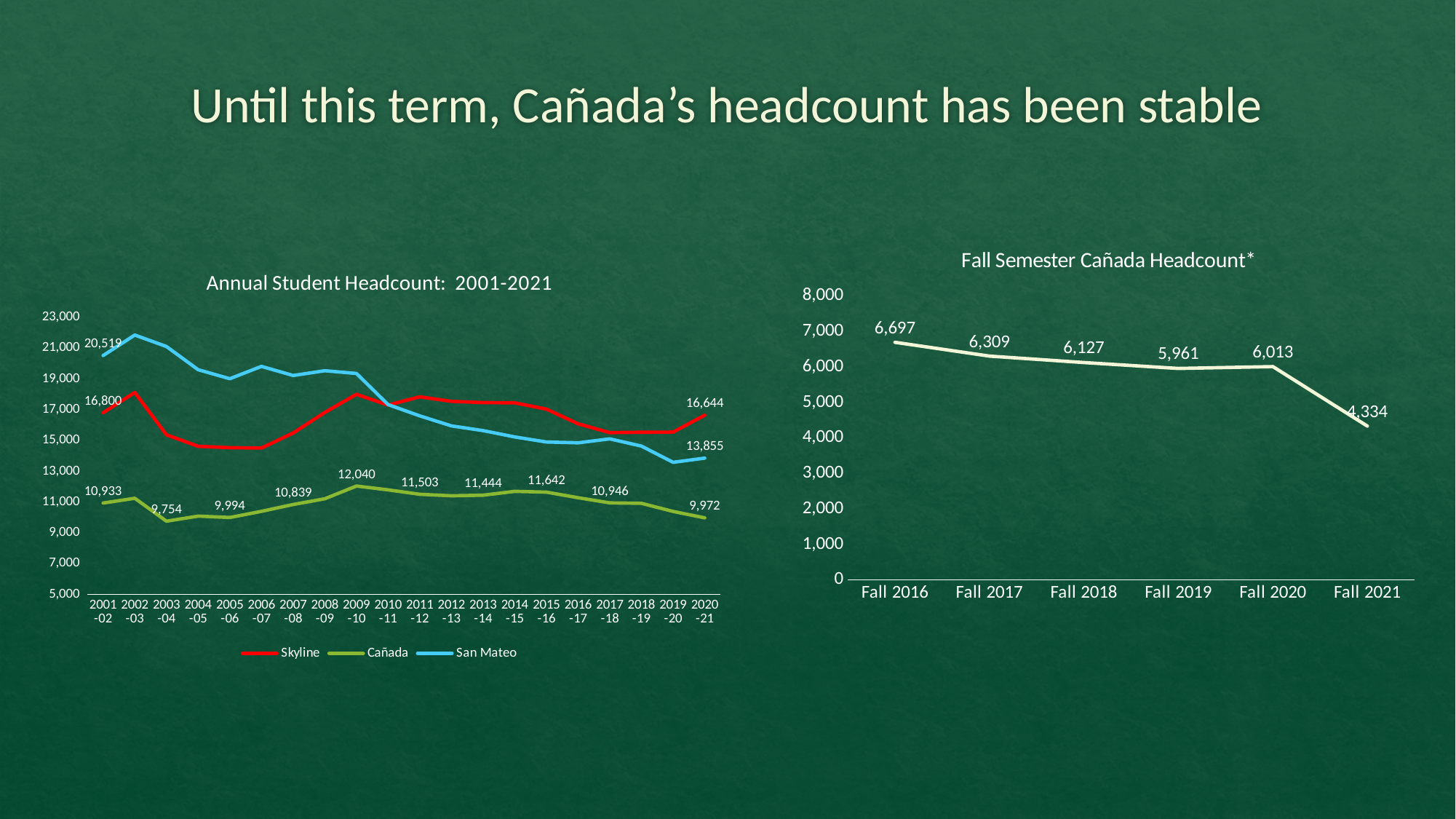
In the Fall Semester Cañada Headcount chart, which term has the lowest headcount? Fall 2021 In the Annual Student Headcount: 2001-2021 chart, what is the Cañada headcount for 2009-10? 12,040 In the Fall Semester Cañada Headcount chart, what is the headcount for Fall 2021? 4,334 What kind of chart is the Annual Student Headcount: 2001-2021 chart? Line chart How many series does the legend of the Annual Student Headcount: 2001-2021 chart list? 3 In the Annual Student Headcount: 2001-2021 chart, what is the San Mateo headcount for 2001-02? 20,519 In the Fall Semester Cañada Headcount chart, which is larger, the Fall 2019 or the Fall 2020 headcount? Fall 2020 In the Annual Student Headcount: 2001-2021 chart, does the San Mateo line rise or fall overall from 2001-02 to 2020-21? Fall In the Fall Semester Cañada Headcount chart, how many terms are plotted? 6 In the Fall Semester Cañada Headcount chart, which term has the highest headcount? Fall 2016 In the Annual Student Headcount: 2001-2021 chart, which is larger in 2020-21, Skyline or San Mateo? Skyline In the Fall Semester Cañada Headcount chart, what is the difference between the Fall 2020 and Fall 2021 headcounts? 1,679